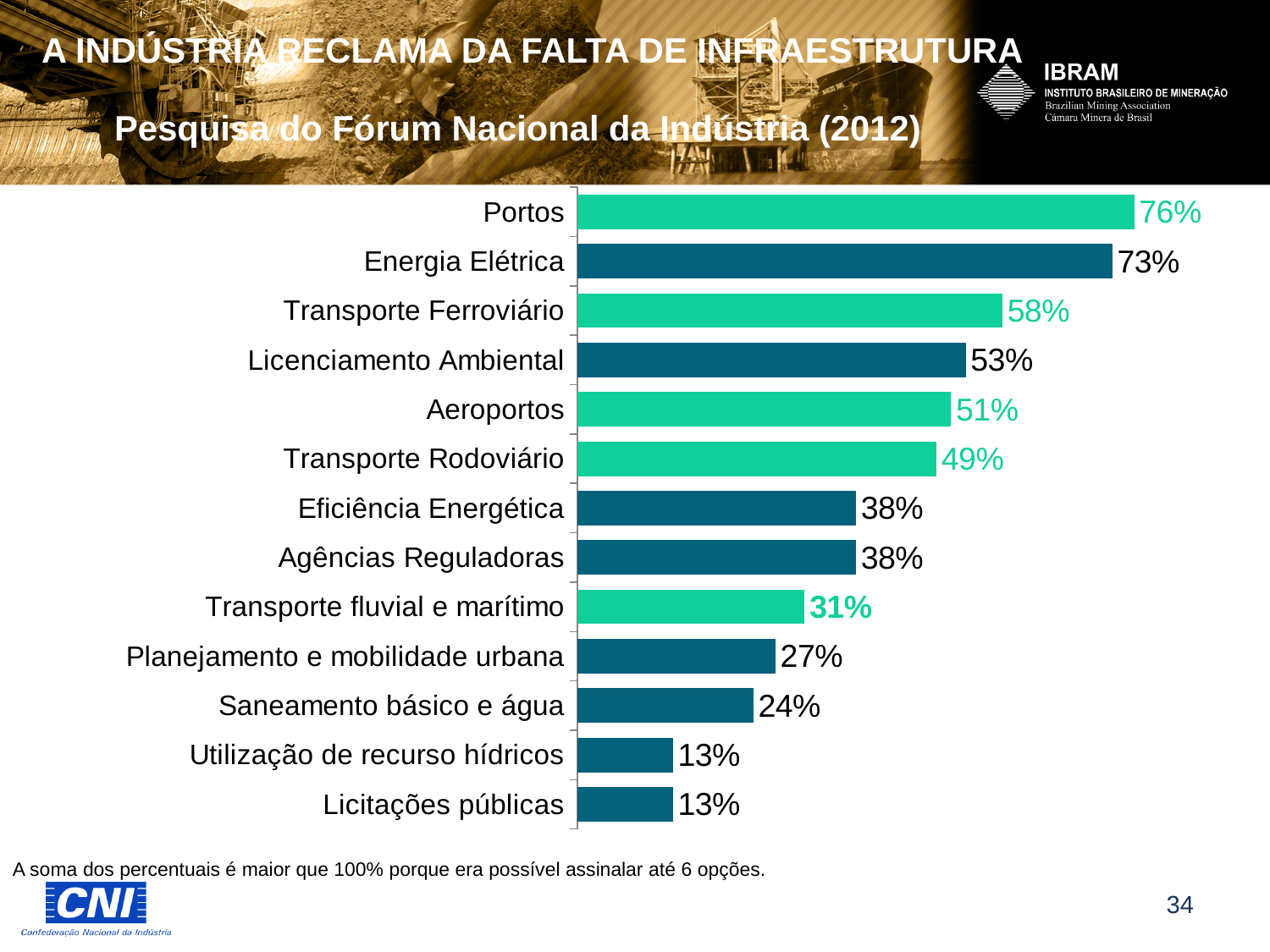
How many categories are shown in the chart? 13 Which category has the highest value? Portos What is the difference between the values for Portos and Energia Elétrica? 3% Which is larger, the value for Aeroportos or the value for Eficiência Energética? Aeroportos What is the value for Portos? 76% What kind of chart is shown on the slide? Bar chart What is the value for Licenciamento Ambiental? 53% What is the value for Transporte fluvial e marítimo? 31% Which two categories share the value 38%? Eficiência Energética and Agências Reguladoras Which is larger, the value for Saneamento básico e água or the value for Planejamento e mobilidade urbana? Planejamento e mobilidade urbana What value is shown for Licitações públicas? 13% What is the difference between the values for Transporte Ferroviário and Transporte Rodoviário? 9%